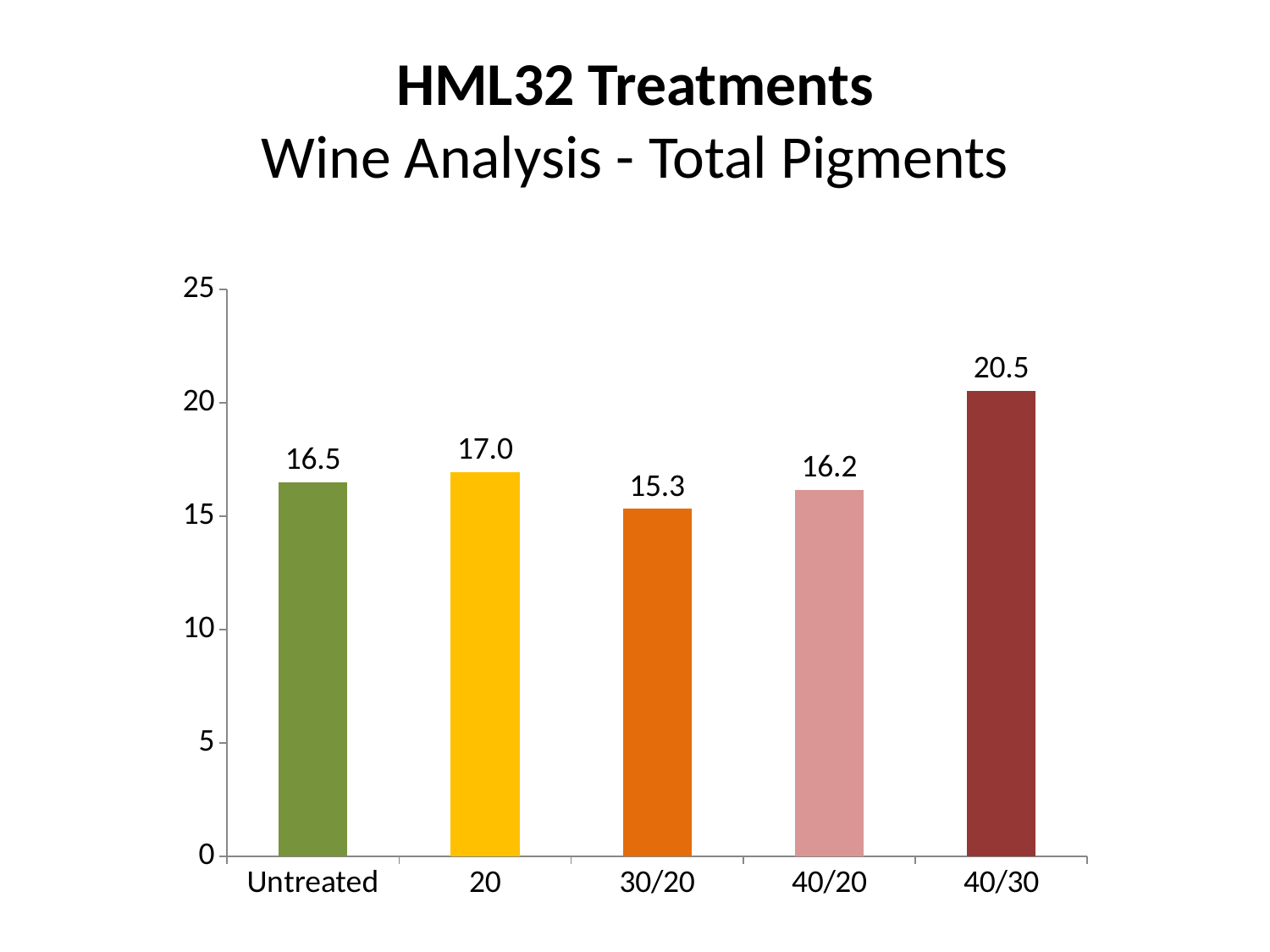
Which is larger, the value for 20 or the value for 40/20? 20 What is the difference between the 40/30 and Untreated values? 4.0 How many treatments are shown on the x axis? 5 Which treatment has the lowest total pigments value? 30/20 What is the title of the chart? HML32 Treatments Wine Analysis - Total Pigments What is the value for the 30/20 treatment? 15.3 What is the difference between the 20 and 30/20 values? 1.7 What kind of chart is shown on the slide? bar chart Is the value for 40/30 greater or less than 20? greater What is the value for the 40/30 treatment? 20.5 What is the total pigments value for the Untreated treatment? 16.5 Which treatment has the highest total pigments value? 40/30